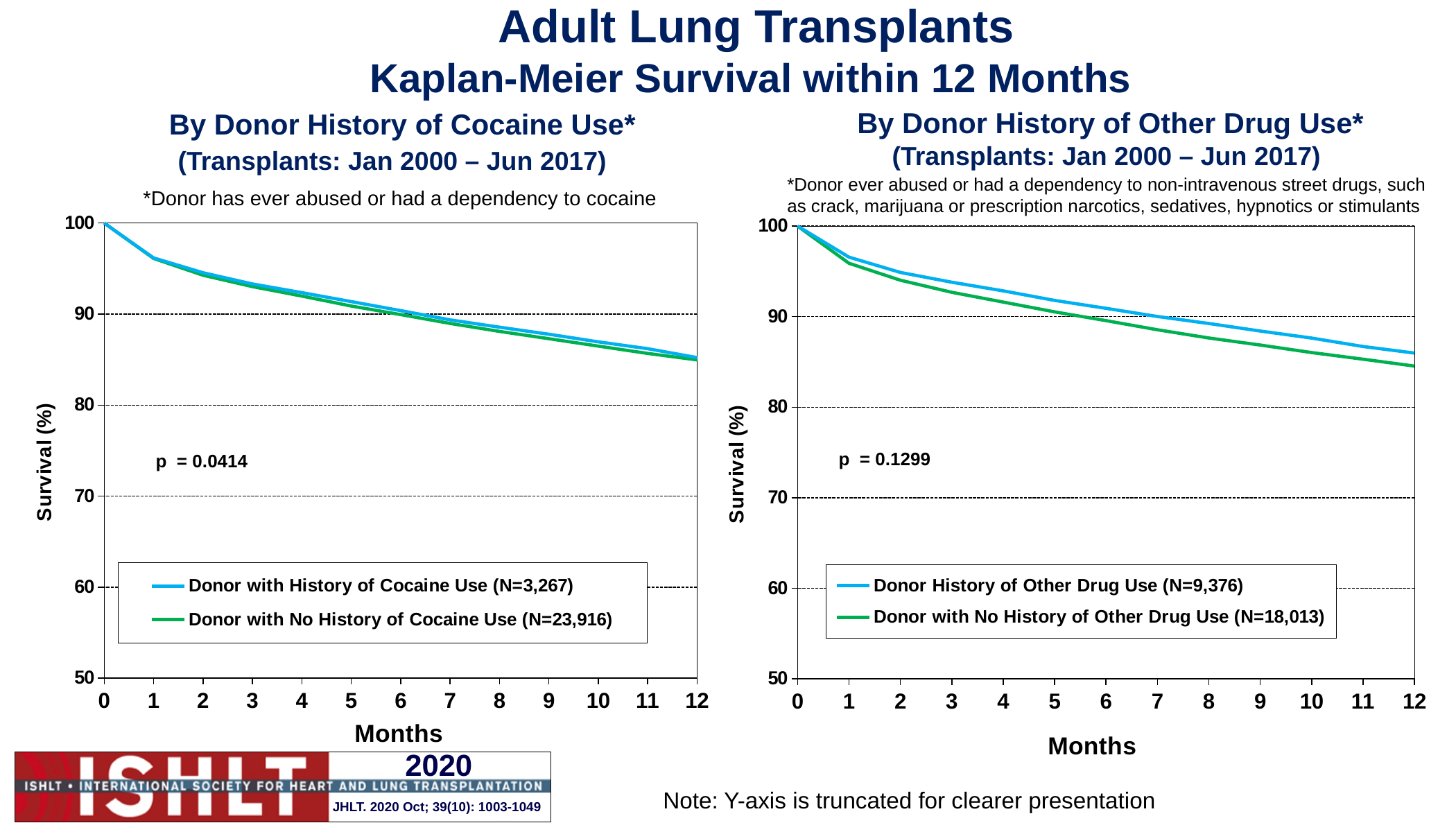
What kind of chart is the 'By Donor History of Cocaine Use' chart on the left? Line chart What p-value is printed on the 'By Donor History of Other Drug Use' chart? p = 0.1299 In the 'By Donor History of Other Drug Use' chart, is the survival for Donor with No History of Other Drug Use at month 12 greater or less than 90? less In the 'By Donor History of Other Drug Use' chart, which series has higher survival at month 12? Donor History of Other Drug Use (N=9,376) What p-value is printed on the 'By Donor History of Cocaine Use' chart? p = 0.0414 How many series does the legend of the 'By Donor History of Cocaine Use' chart list? 2 In the 'By Donor History of Other Drug Use' chart, what is the N given in the legend for Donor with No History of Other Drug Use? 18,013 In the 'By Donor History of Cocaine Use' chart, do the survival curves rise or fall as months increase? Fall How many series does the legend of the 'By Donor History of Other Drug Use' chart list? 2 In the 'By Donor History of Cocaine Use' chart, is the survival for Donor with History of Cocaine Use at month 12 greater or less than 90? less In the 'By Donor History of Cocaine Use' chart, what is the survival value for both series at month 0? 100 In the 'By Donor History of Cocaine Use' chart, is the survival for Donor with No History of Cocaine Use at month 9 greater or less than 80? greater